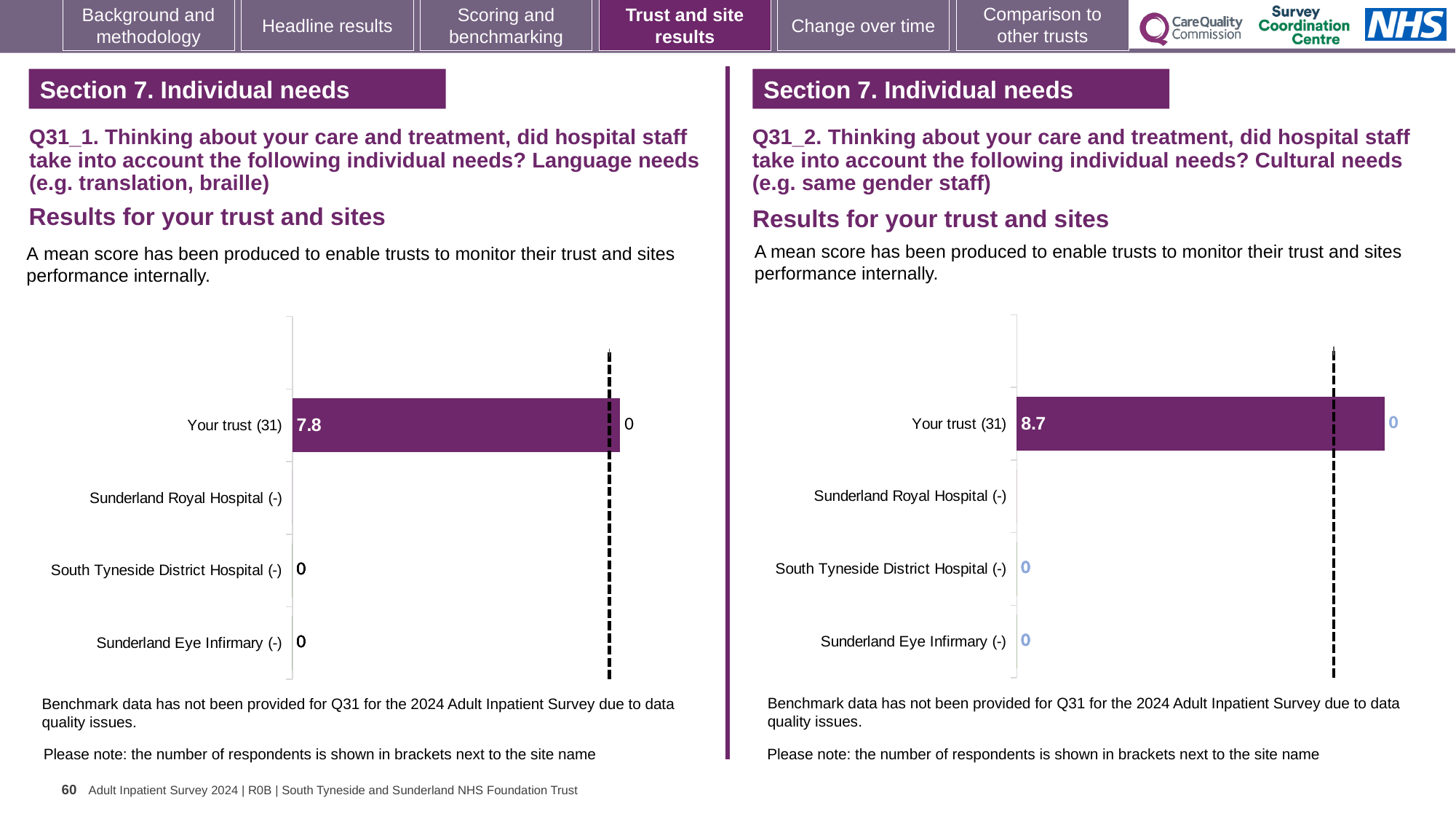
On the right chart (Q31_2, Cultural needs), what is the mean score for Your trust? 8.7 On the left chart (Q31_1, Language needs), what is the mean score for Your trust? 7.8 What kind of chart is used on the left side of the slide for Q31_1? Bar chart What is the difference between the Your trust score on the right chart (Q31_2, 8.7) and on the left chart (Q31_1, 7.8)? 0.9 On the right chart (Q31_2), what is the name of the second category listed below Your trust? South Tyneside District Hospital (-) On the left chart (Q31_1), how many respondents are shown in brackets next to Your trust? 31 On the right chart (Q31_2), which category has the highest mean score? Your trust (31) Is the Your trust score on the left chart (Q31_1) larger or smaller than the Your trust score on the right chart (Q31_2)? Smaller On the left chart (Q31_1), which category has the highest mean score? Your trust (31) How many categories are listed on the vertical axis of the right chart (Q31_2)? 4 How many categories are listed on the vertical axis of the left chart (Q31_1)? 4